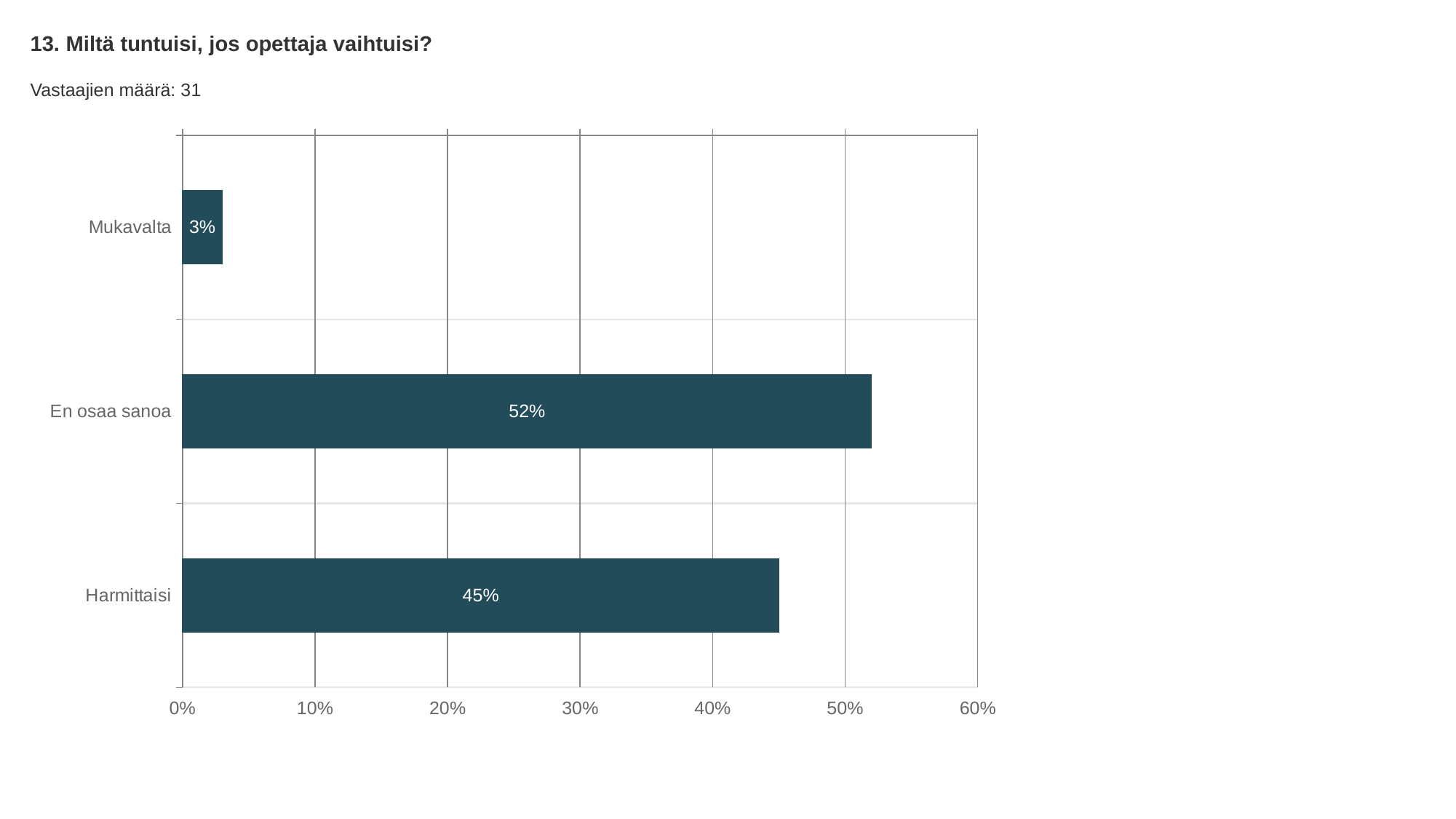
Which category has the lowest value? Mukavalta What is the value for Harmittaisi? 45% Which category has the highest value? En osaa sanoa Which is larger, the value for Harmittaisi or the value for Mukavalta? Harmittaisi What kind of chart is shown on the slide? bar chart What is the difference between the values for Harmittaisi and Mukavalta? 42% What is the difference between the values for En osaa sanoa and Harmittaisi? 7% What is the title of the chart? 13. Miltä tuntuisi, jos opettaja vaihtuisi? What is the value for Mukavalta? 3% What is the value for En osaa sanoa? 52% How many categories are shown in the chart? 3 Is the value for En osaa sanoa greater or less than 50%? greater